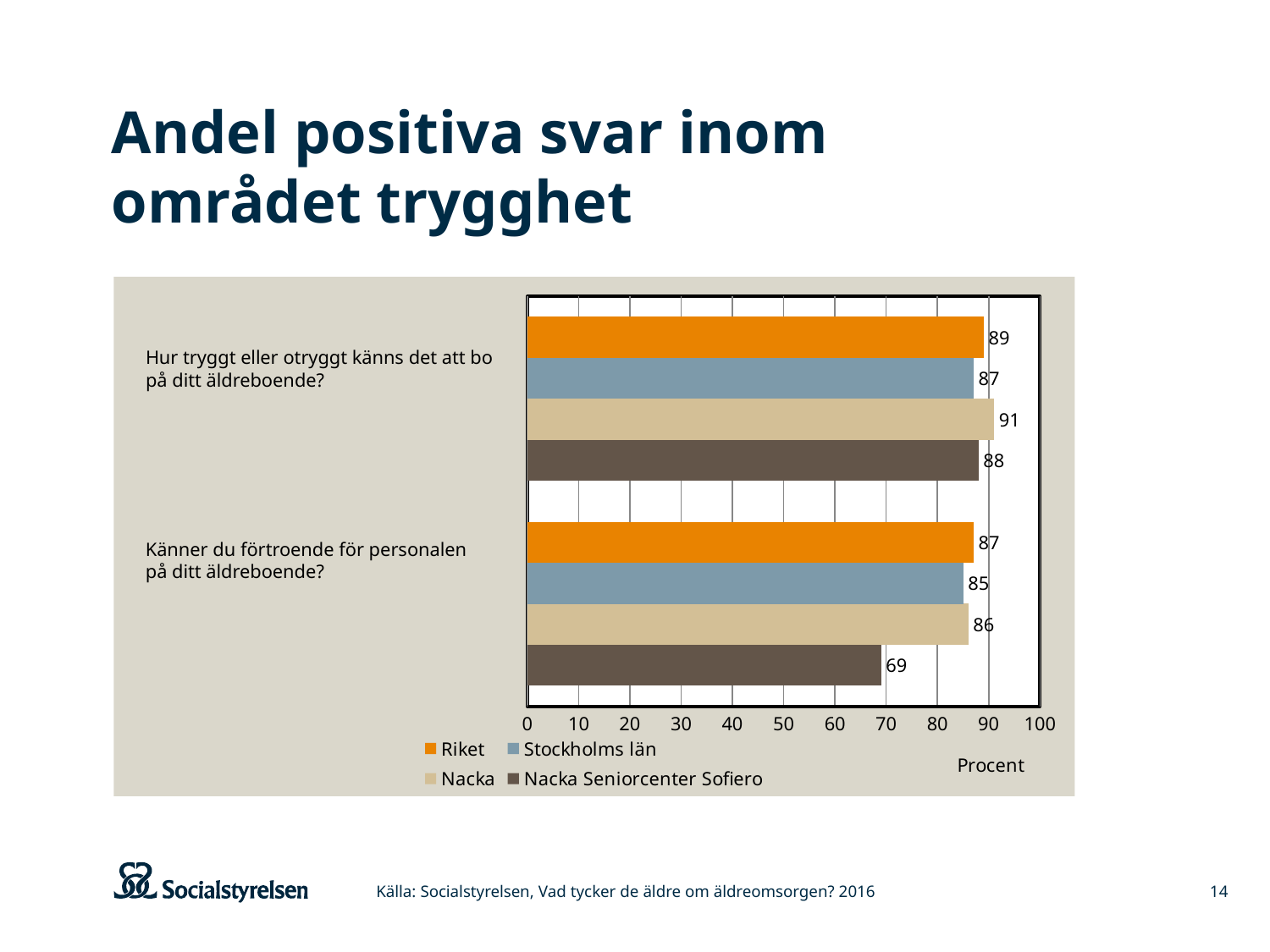
What kind of chart is shown on the slide? Bar chart What is the value for Nacka Seniorcenter Sofiero for the question 'Känner du förtroende för personalen på ditt äldreboende?' 69 What is the difference between the Riket value and the Stockholms län value for the question 'Hur tryggt eller otryggt känns det att bo på ditt äldreboende?' 2 What is the difference between the Nacka value and the Nacka Seniorcenter Sofiero value for the question 'Känner du förtroende för personalen på ditt äldreboende?' 17 What is the value for Stockholms län for the question 'Känner du förtroende för personalen på ditt äldreboende?' 85 How many questions (categories) are shown on the chart? 2 Which series has the lowest value for the question 'Känner du förtroende för personalen på ditt äldreboende?' Nacka Seniorcenter Sofiero Is the value for Nacka Seniorcenter Sofiero for 'Känner du förtroende för personalen på ditt äldreboende?' greater or less than 80? less How many series does the legend list? 4 Which series has the highest value for the question 'Hur tryggt eller otryggt känns det att bo på ditt äldreboende?' Nacka What is the value for Riket for the question 'Hur tryggt eller otryggt känns det att bo på ditt äldreboende?' 89 Which is larger for Nacka Seniorcenter Sofiero: the value for 'Hur tryggt eller otryggt känns det att bo på ditt äldreboende?' or the value for 'Känner du förtroende för personalen på ditt äldreboende?' Hur tryggt eller otryggt känns det att bo på ditt äldreboende?